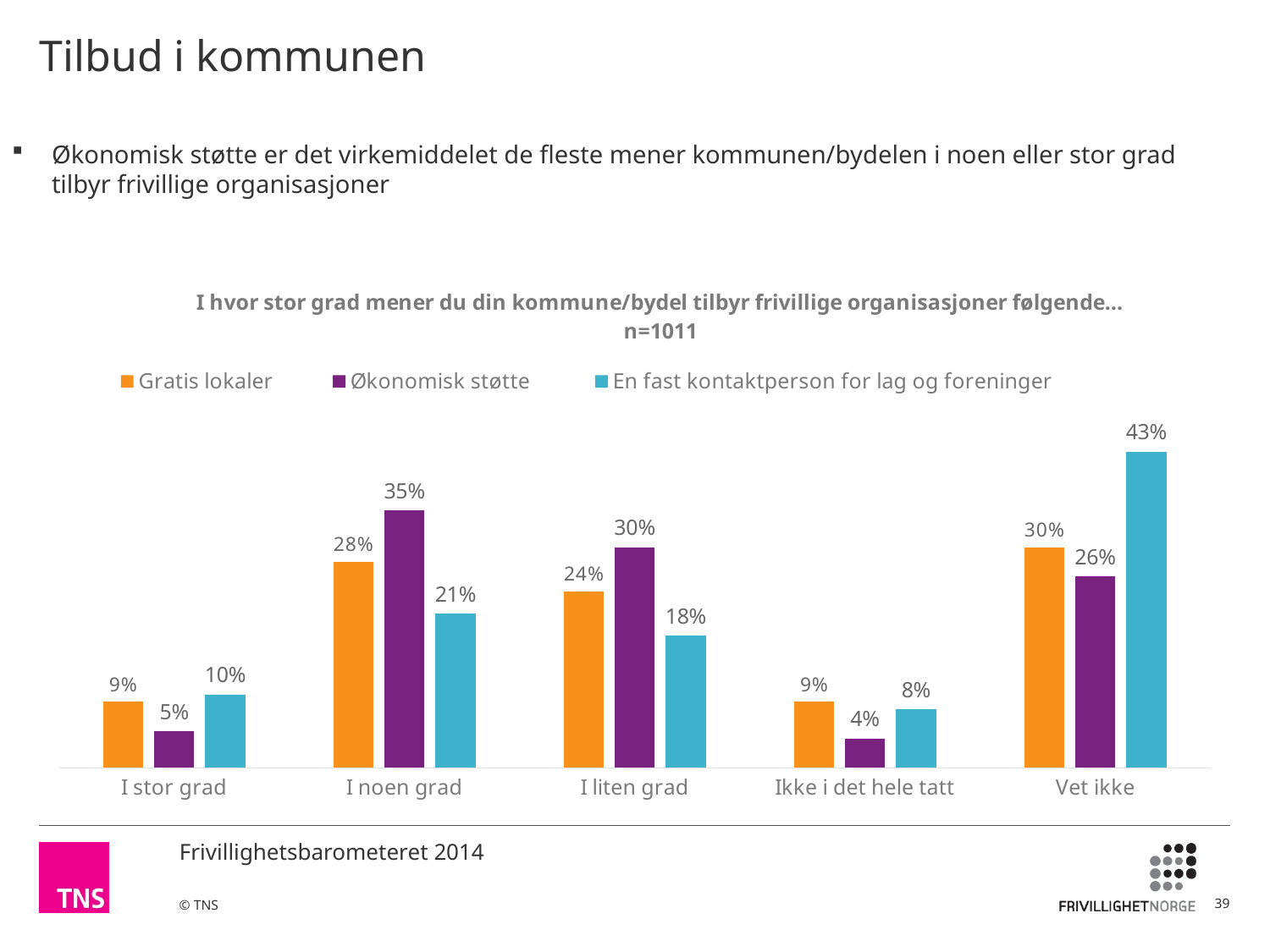
What is the difference between "En fast kontaktperson for lag og foreninger" and "Økonomisk støtte" in the "Vet ikke" category? 17% What kind of chart is shown on the slide? Bar chart Which category has the highest value for "En fast kontaktperson for lag og foreninger"? Vet ikke What is the sample size (n) stated in the chart title? n=1011 What is the value for "Økonomisk støtte" in the "I noen grad" category? 35% How many categories are shown on the x axis? 5 What is the difference between "Økonomisk støtte" and "Gratis lokaler" in the "I noen grad" category? 7% What is the value for "En fast kontaktperson for lag og foreninger" in the "Vet ikke" category? 43% In the "Vet ikke" category, which is larger: "Gratis lokaler" or "Økonomisk støtte"? Gratis lokaler How many series does the legend list? 3 Which category has the lowest value for "Økonomisk støtte"? Ikke i det hele tatt What is the value for "Gratis lokaler" in the "I liten grad" category? 24%